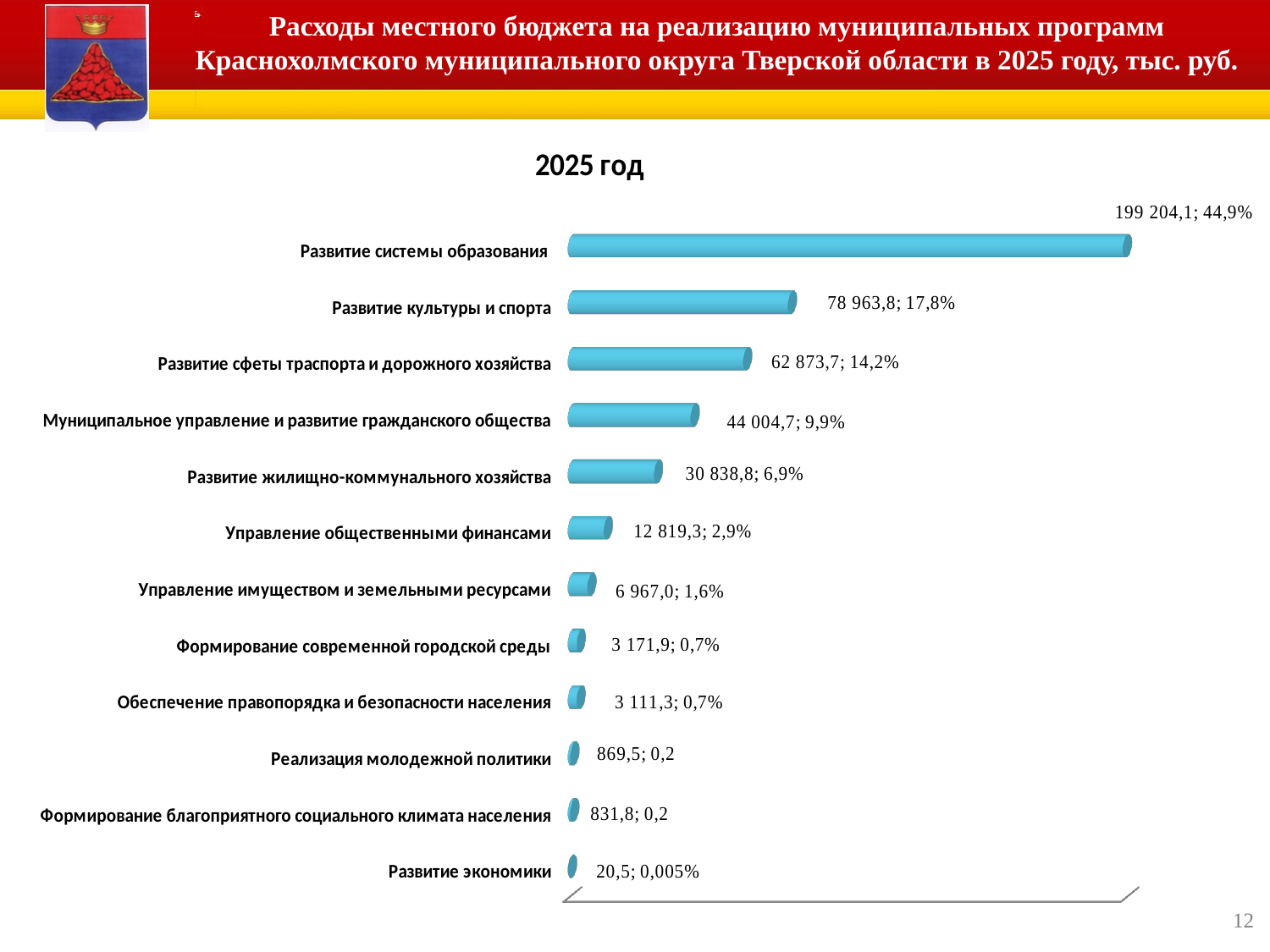
What is the value shown for «Развитие экономики»? 20,5 How many programs (categories) are shown in the chart? 12 What is the title shown above the chart? 2025 год What is the difference between the values for «Формирование современной городской среды» and «Обеспечение правопорядка и безопасности населения»? 60,6 What is the value shown for «Развитие системы образования»? 199 204,1 What is the difference between the values for «Развитие культуры и спорта» and «Развитие сфеты траспорта и дорожного хозяйства»? 16 090,1 What is the value shown for «Муниципальное управление и развитие гражданского общества»? 44 004,7 What type of chart is shown on the slide? Bar chart Which program has the highest expenditure? Развитие системы образования Which is larger: the value for «Развитие жилищно-коммунального хозяйства» or for «Управление общественными финансами»? Развитие жилищно-коммунального хозяйства Which program has the lowest expenditure? Развитие экономики What share of expenditure is shown for «Развитие культуры и спорта»? 17,8%